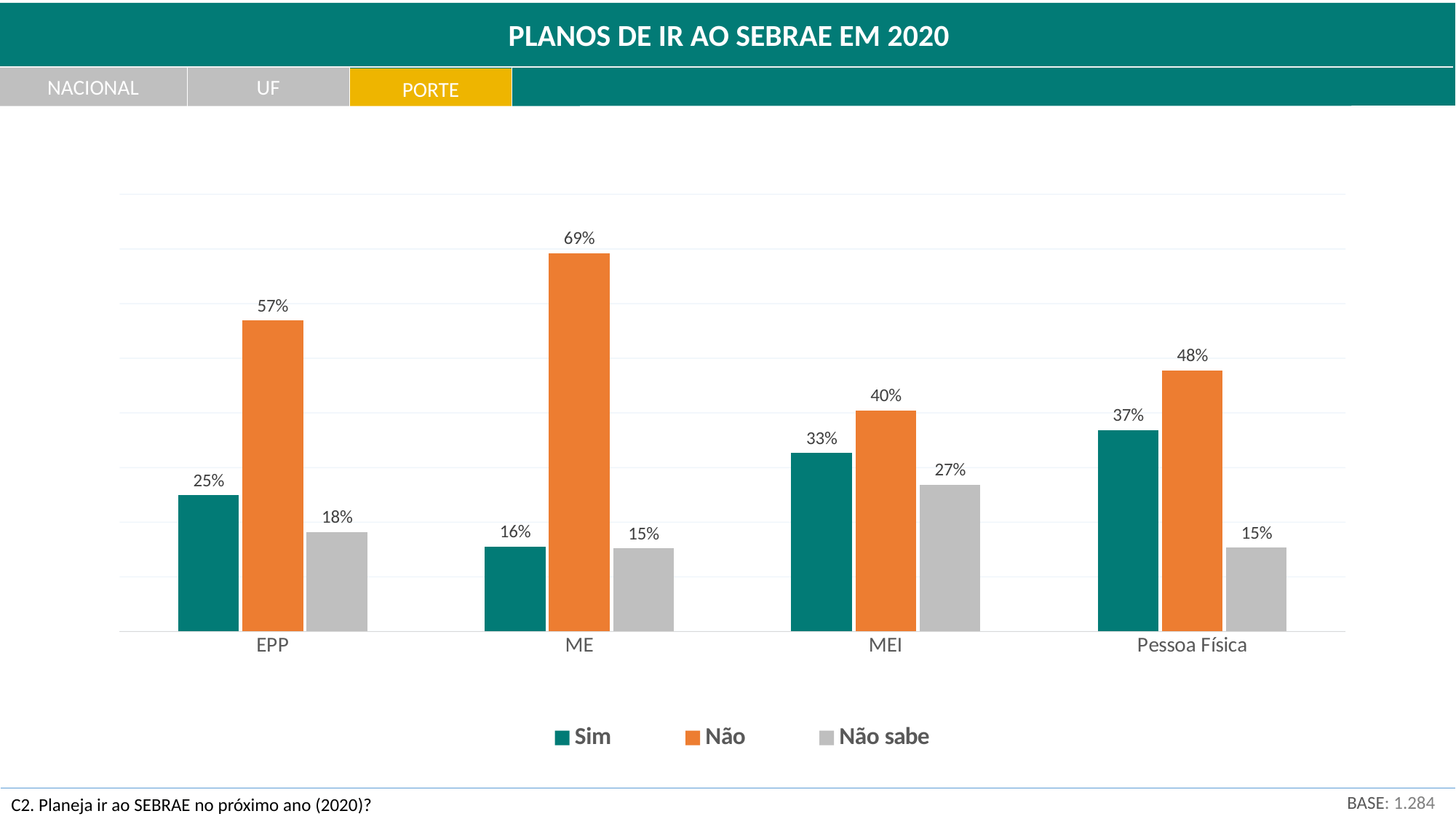
How many categories are shown on the x axis? 4 Which is larger: the "Sim" value for MEI or the "Sim" value for EPP? MEI Which series is shown in orange? Não What is the difference between the "Não" and "Sim" values in the EPP category? 32% What is the title of the slide? PLANOS DE IR AO SEBRAE EM 2020 What is the value for "Não" in the ME category? 69% What kind of chart is shown on the slide? Bar chart Which category has the lowest value for "Sim"? ME What is the value for "Sim" in the Pessoa Física category? 37% Which category has the highest value for "Não"? ME What is the value for "Não sabe" in the MEI category? 27% How many series does the legend list? 3